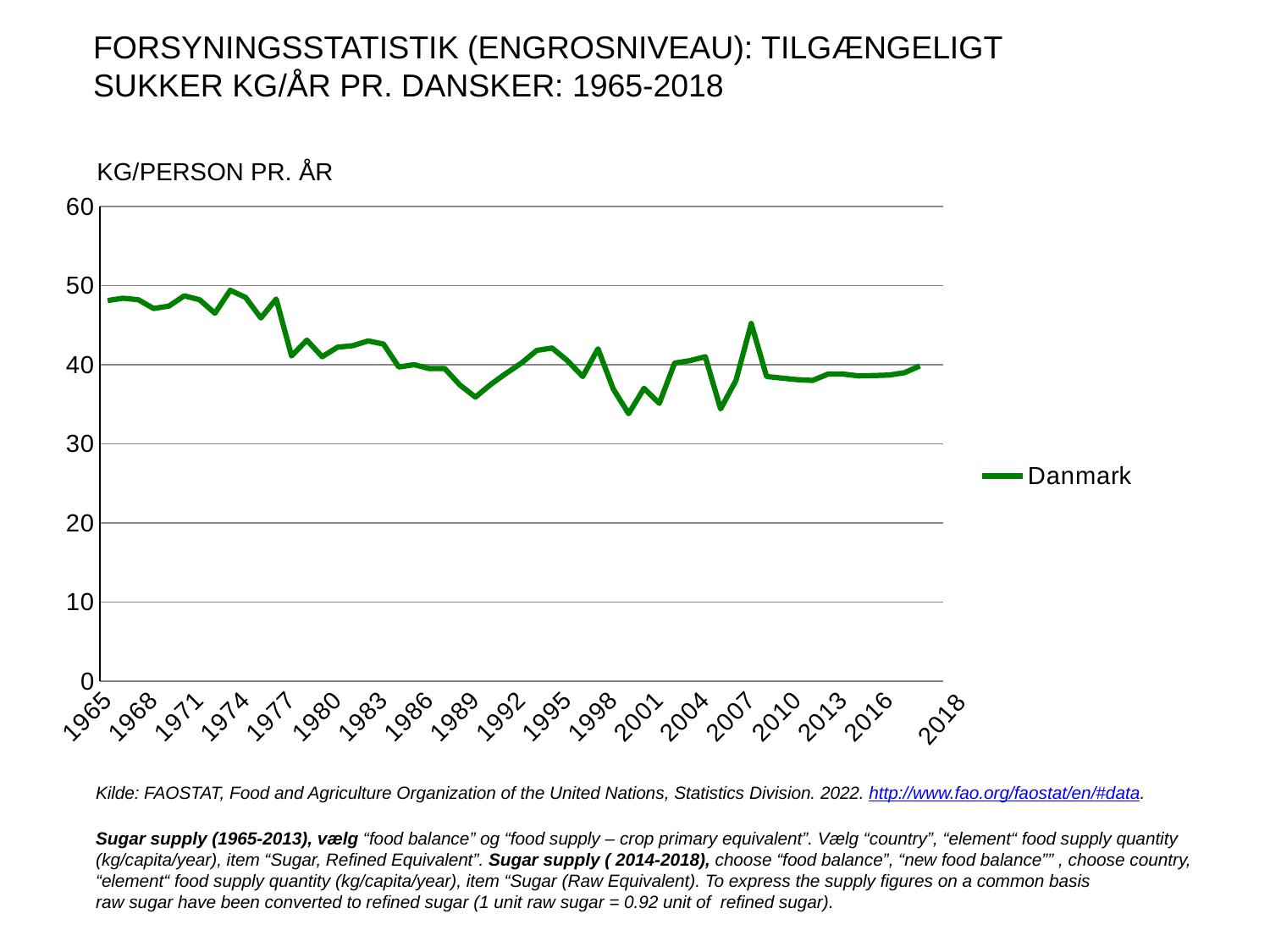
Is the value for Danmark in 1974 greater or less than 40? greater Is the value for Danmark in 1989 greater or less than 40? less What is the label on the vertical axis of the chart? KG/PERSON PR. ÅR Is the value for Danmark in 2007 greater or less than 40? greater Which is larger, the value for Danmark in 1977 or in 1989? 1977 What kind of chart is shown on the slide? Line chart What is the name of the series shown in the legend? Danmark How many series does the legend list? 1 Which year has the highest value for Danmark? 1973 Overall, does the value for Danmark rise or fall from 1965 to 2018? Fall